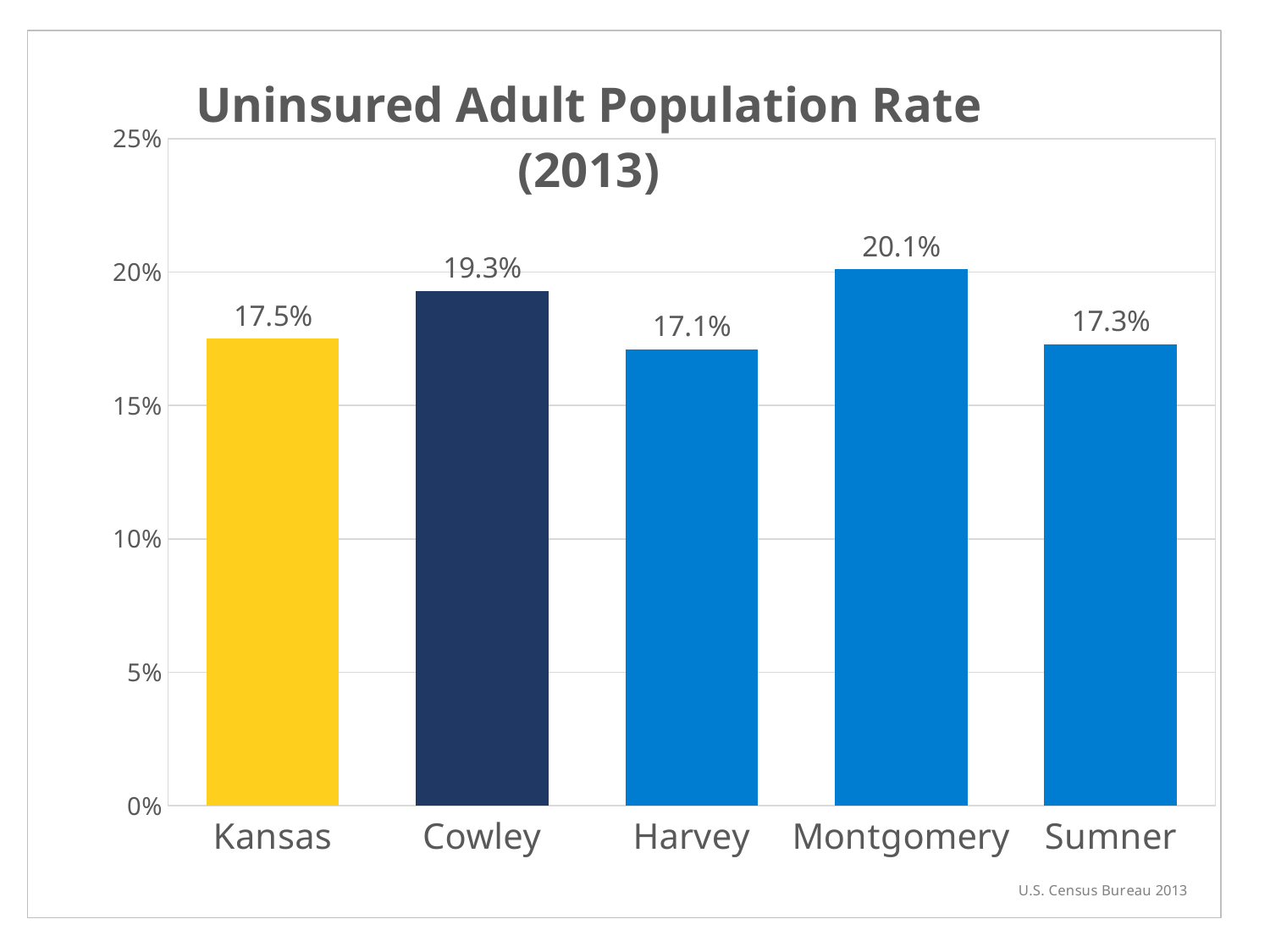
Which has a higher uninsured adult population rate, Cowley or Sumner? Cowley Which category has the highest uninsured adult population rate? Montgomery What is the uninsured adult population rate for Montgomery? 20.1% What is the title of the chart? Uninsured Adult Population Rate (2013) What is the uninsured adult population rate for Cowley? 19.3% Which category has the lowest uninsured adult population rate? Harvey What is the difference between the rates for Montgomery and Harvey? 3.0% How many categories are shown on the x axis? 5 Is the value for Montgomery greater or less than 20%? greater What is the uninsured adult population rate for Kansas? 17.5% What kind of chart is shown on the slide? Bar chart What is the difference between the rates for Cowley and Kansas? 1.8%